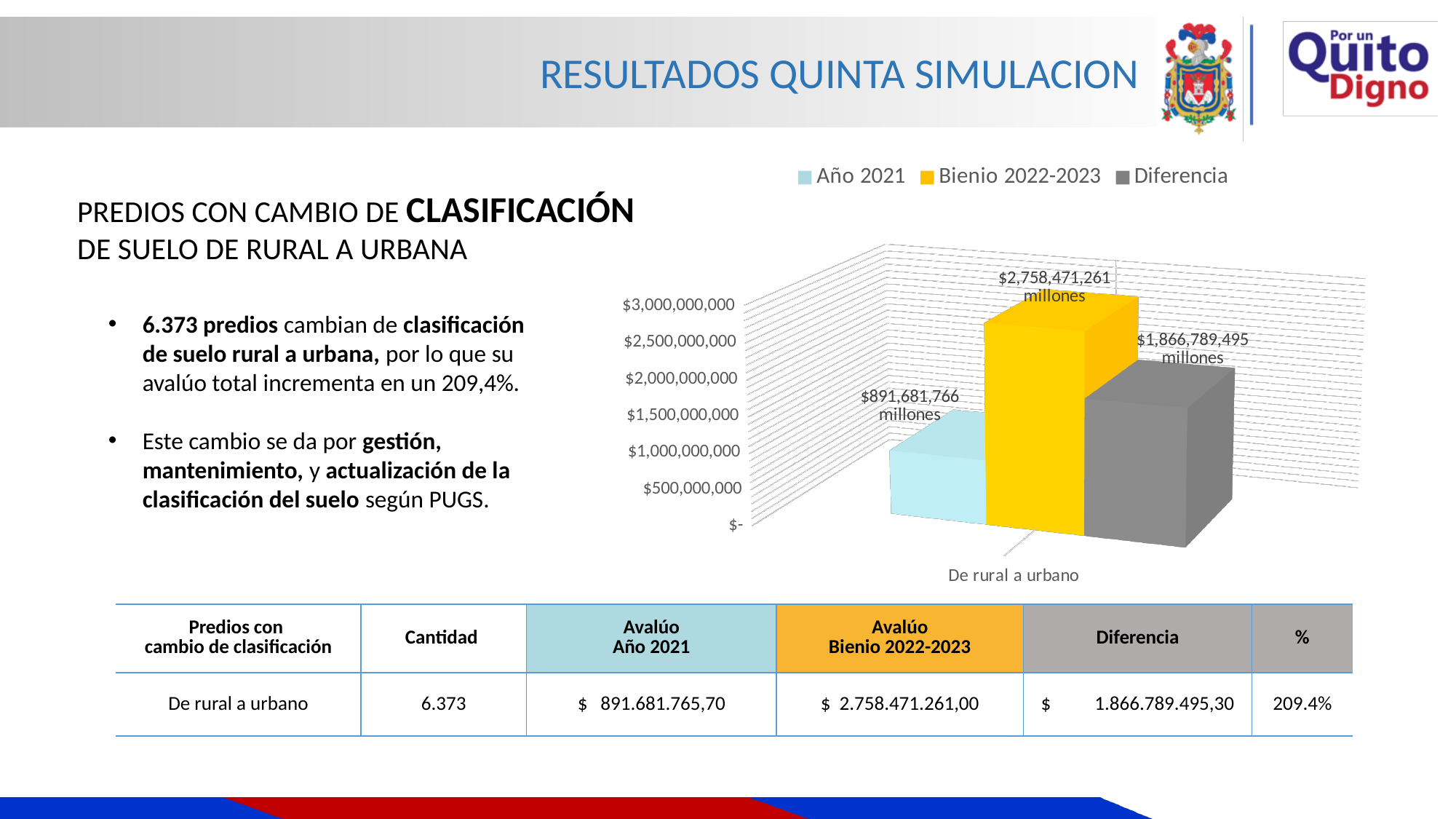
How many series does the chart legend list? 3 What type of chart is shown on the slide? bar chart What is the value of the Diferencia bar in the chart? $1,866,789,495 millones How many categories are shown on the x axis of the chart? 1 Is the value for Bienio 2022-2023 greater or less than $2,500,000,000? greater Which series has the highest bar in the chart? Bienio 2022-2023 Is the Bienio 2022-2023 bar larger or smaller than the Año 2021 bar? larger What is the category label shown on the x axis of the chart? De rural a urbano Is the value for Año 2021 greater or less than $1,000,000,000? less What is the value of the Bienio 2022-2023 bar in the chart? $2,758,471,261 millones Which series has the lowest bar in the chart? Año 2021 What is the value of the Año 2021 bar in the chart? $891,681,766 millones